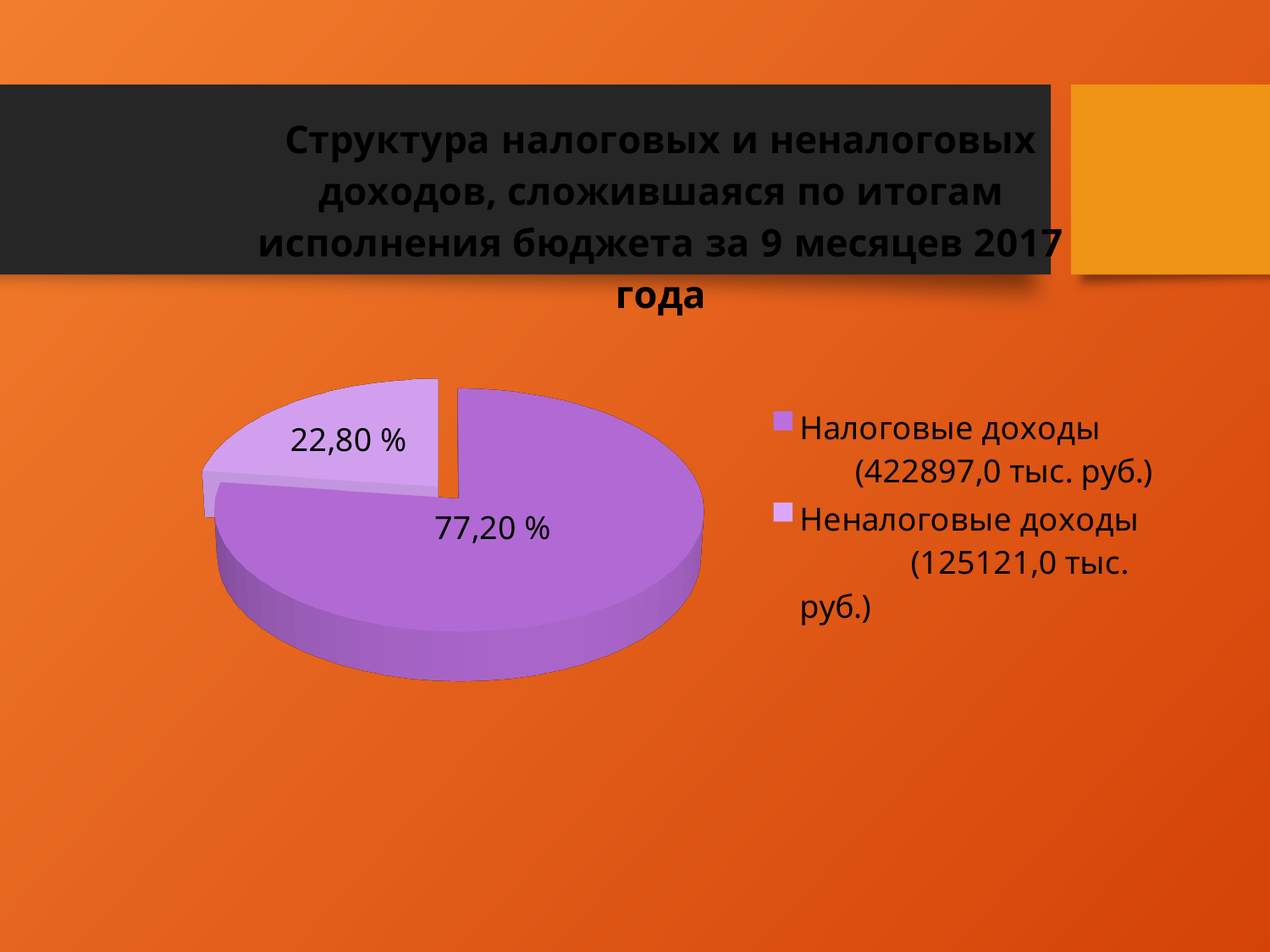
Which slice is the smallest? Неналоговые доходы Which is larger, Налоговые доходы or Неналоговые доходы? Налоговые доходы What amount in thousand rubles does the legend give for Неналоговые доходы? 125121,0 тыс. руб. What kind of chart is shown on the slide? Pie chart What share of the pie does Неналоговые доходы take? 22,80 % How many entries does the legend list? 2 What amount in thousand rubles does the legend give for Налоговые доходы? 422897,0 тыс. руб. What share of the pie does Налоговые доходы take? 77,20 % What is the difference in percentage points between the Налоговые доходы and Неналоговые доходы slices? 54,40 % How many slices does the pie chart have? 2 What is the title of the chart? Структура налоговых и неналоговых доходов, сложившаяся по итогам исполнения бюджета за 9 месяцев 2017 года Which slice is the largest? Налоговые доходы